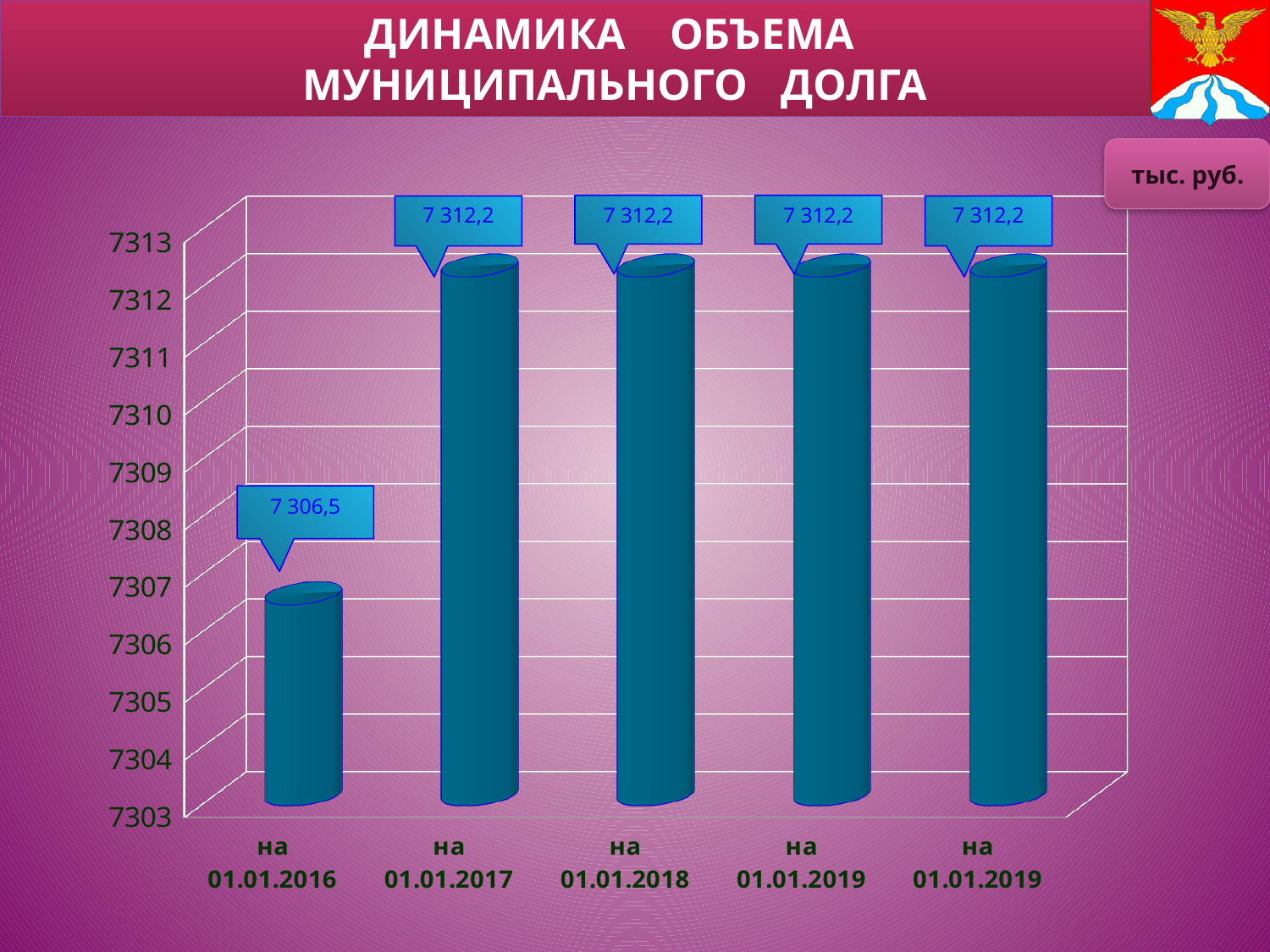
What is the difference between the values for на 01.01.2017 and на 01.01.2016? 5,7 What kind of chart is shown on the slide? bar chart What is the value for на 01.01.2018? 7 312,2 Is the value for на 01.01.2016 greater or less than 7307? less Is the value for на 01.01.2018 greater or less than 7310? greater Which category has the lowest value? на 01.01.2016 How many bars are shown in the chart? 5 Which is larger, the value for на 01.01.2016 or the value for на 01.01.2017? на 01.01.2017 What is the value for на 01.01.2017? 7 312,2 How many bars have the value 7 312,2? 4 Do the values rise or fall from на 01.01.2016 to на 01.01.2017? rise What is the value for на 01.01.2016? 7 306,5